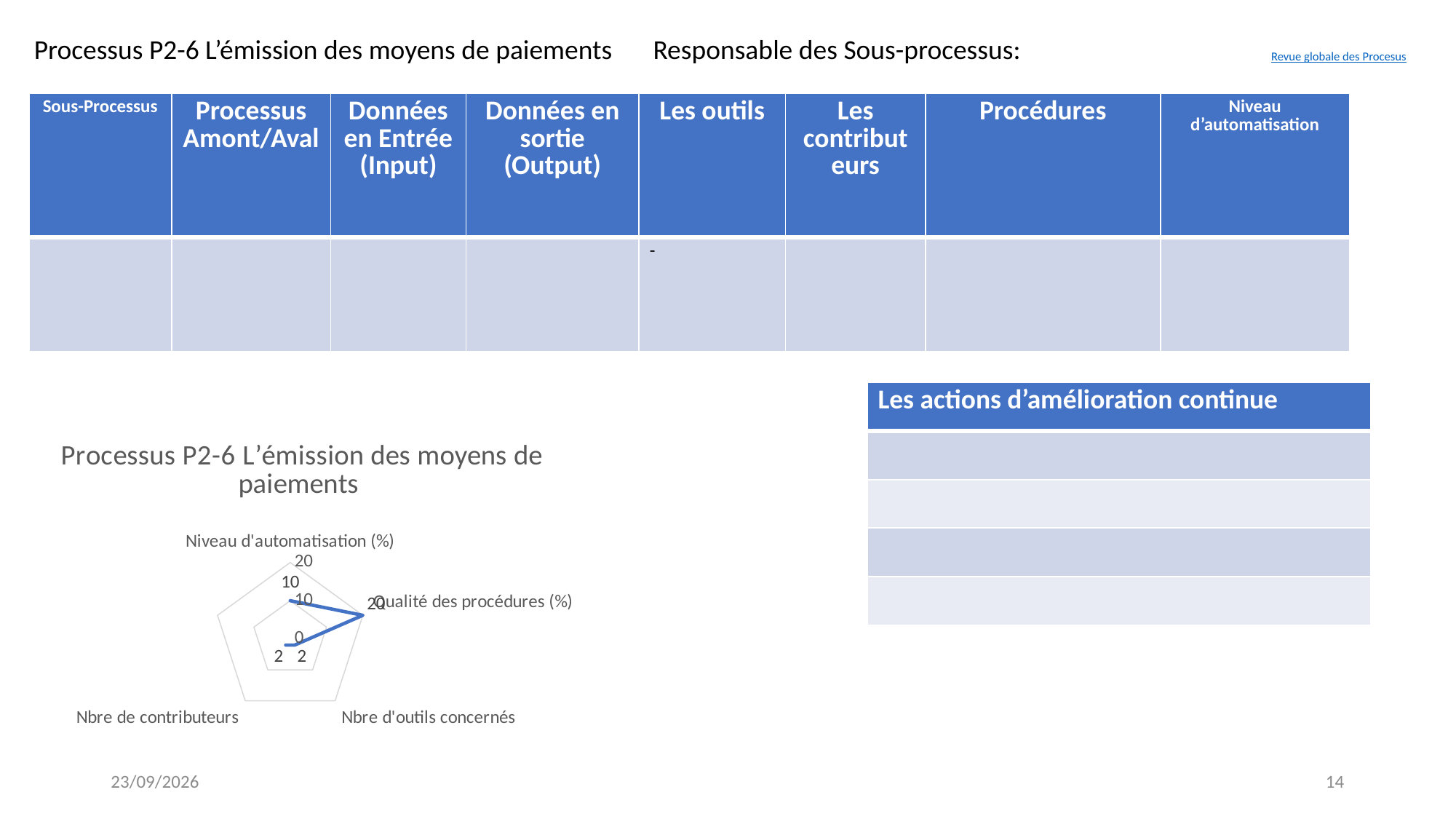
What is the value for Qualité des procédures (%) in the radar chart? 20 What is the title of the chart on the slide? Processus P2-6 L’émission des moyens de paiements What kind of chart is shown on the slide? radar chart How many axis labels are readable on the radar chart? 4 Which is larger in the radar chart, the value for Qualité des procédures (%) or the value for Niveau d'automatisation (%)? Qualité des procédures (%) Is the value for Niveau d'automatisation (%) greater or less than 20? less What is the highest tick value shown on the radar chart's scale? 20 What is the difference between the value for Qualité des procédures (%) and the value for Niveau d'automatisation (%)? 10 What is the value for Niveau d'automatisation (%) in the radar chart? 10 Which axis has the highest value in the radar chart? Qualité des procédures (%)